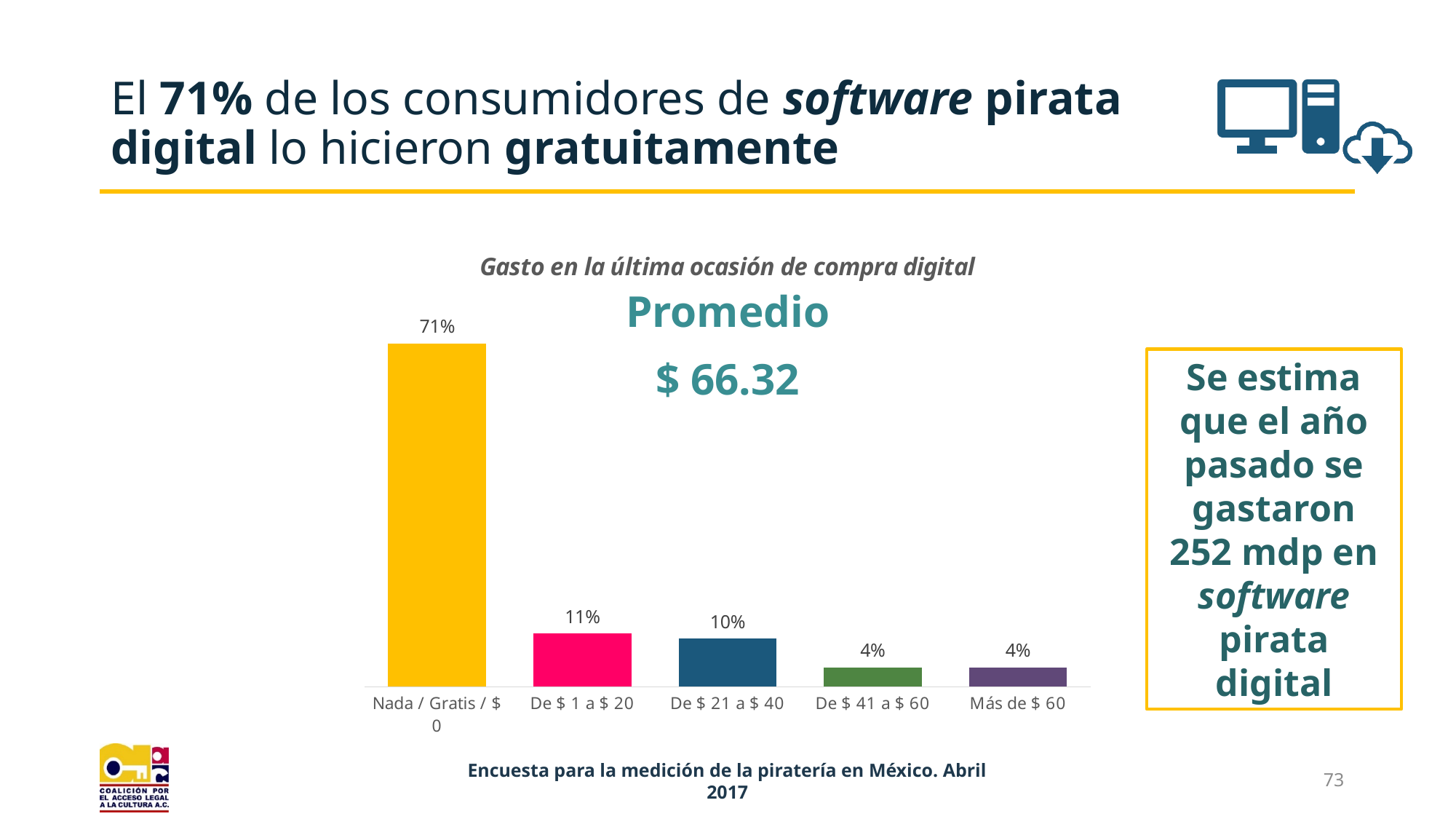
What is the value for the 'De $ 1 a $ 20' category? 11% What is the value for the 'Más de $ 60' category? 4% What is the title of the chart? Gasto en la última ocasión de compra digital What is the value for the 'De $ 21 a $ 40' category? 10% What kind of chart is shown on the slide? Bar chart What is the value for the 'Nada / Gratis / $ 0' category? 71% What average (Promedio) value is shown above the chart? $ 66.32 What is the difference between the values for 'De $ 21 a $ 40' and 'De $ 41 a $ 60'? 6 percentage points Which category has the highest value? Nada / Gratis / $ 0 What is the difference between the values for 'Nada / Gratis / $ 0' and 'De $ 1 a $ 20'? 60 percentage points How many categories are shown on the x axis of the chart? 5 Which is larger, the value for 'De $ 1 a $ 20' or the value for 'De $ 41 a $ 60'? De $ 1 a $ 20